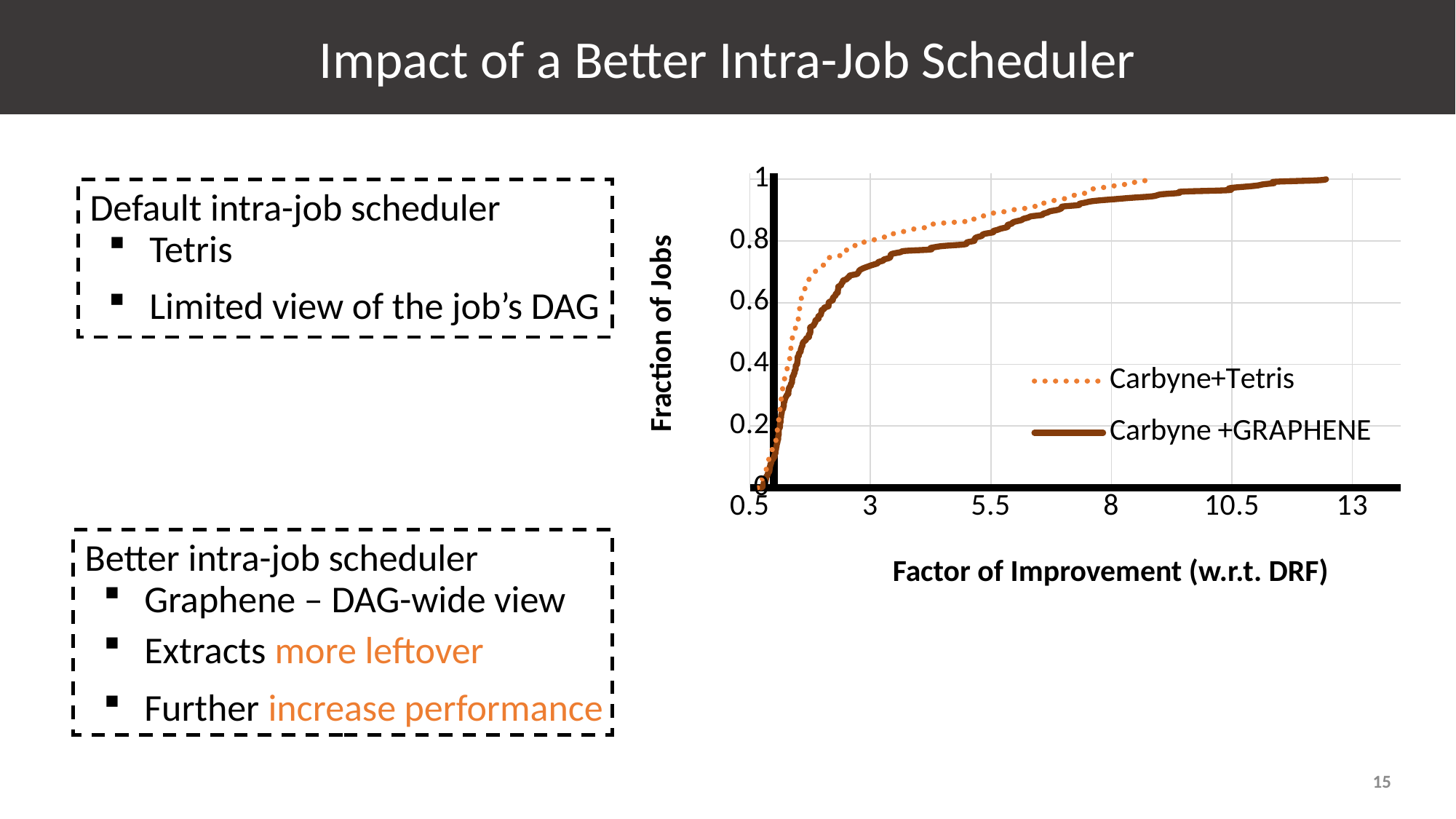
Which series extends to a larger factor of improvement on the x axis, Carbyne+Tetris or Carbyne +GRAPHENE? Carbyne +GRAPHENE How many series does the chart's legend list? 2 What kind of chart is shown on the slide? line chart Do the values of the Carbyne+Tetris series rise or fall along the x axis? rise At a factor of improvement of 5.5, is the fraction of jobs for Carbyne+Tetris greater or less than 0.8? greater Which two series are listed in the chart's legend? Carbyne+Tetris and Carbyne +GRAPHENE At a factor of improvement of 8, is the fraction of jobs for Carbyne +GRAPHENE greater or less than 0.8? greater At a factor of improvement of 3, is the fraction of jobs for Carbyne +GRAPHENE greater or less than 0.8? less Do the values of the Carbyne +GRAPHENE series rise or fall as the factor of improvement increases along the x axis? rise What is the title of the chart's x axis? Factor of Improvement (w.r.t. DRF) At a factor of improvement of 3, which series has the higher fraction of jobs, Carbyne+Tetris or Carbyne +GRAPHENE? Carbyne+Tetris